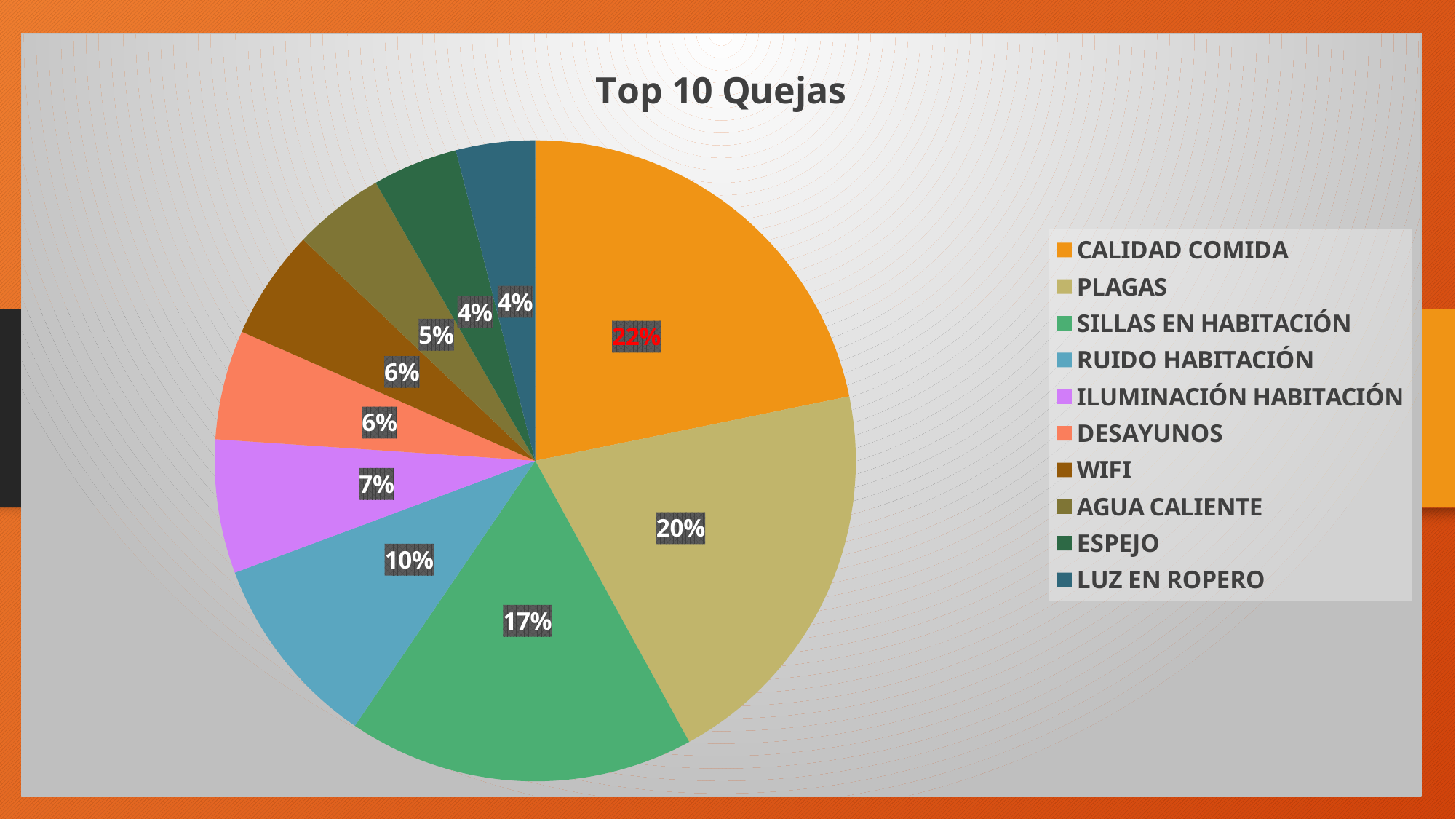
What percentage is shown for PLAGAS? 20% How many categories does the legend list? 10 What percentage is shown for AGUA CALIENTE? 5% What percentage is shown for RUIDO HABITACIÓN? 10% What share of the pie does CALIDAD COMIDA represent? 22% What is the title of the chart? Top 10 Quejas What is the difference in percentage points between CALIDAD COMIDA and PLAGAS? 2 Which category has the largest slice of the pie? CALIDAD COMIDA Which is larger, the slice for ILUMINACIÓN HABITACIÓN or the slice for RUIDO HABITACIÓN? RUIDO HABITACIÓN What is the difference in percentage points between SILLAS EN HABITACIÓN and ESPEJO? 13 What percentage is shown for SILLAS EN HABITACIÓN? 17% What kind of chart is shown on the slide? Pie chart